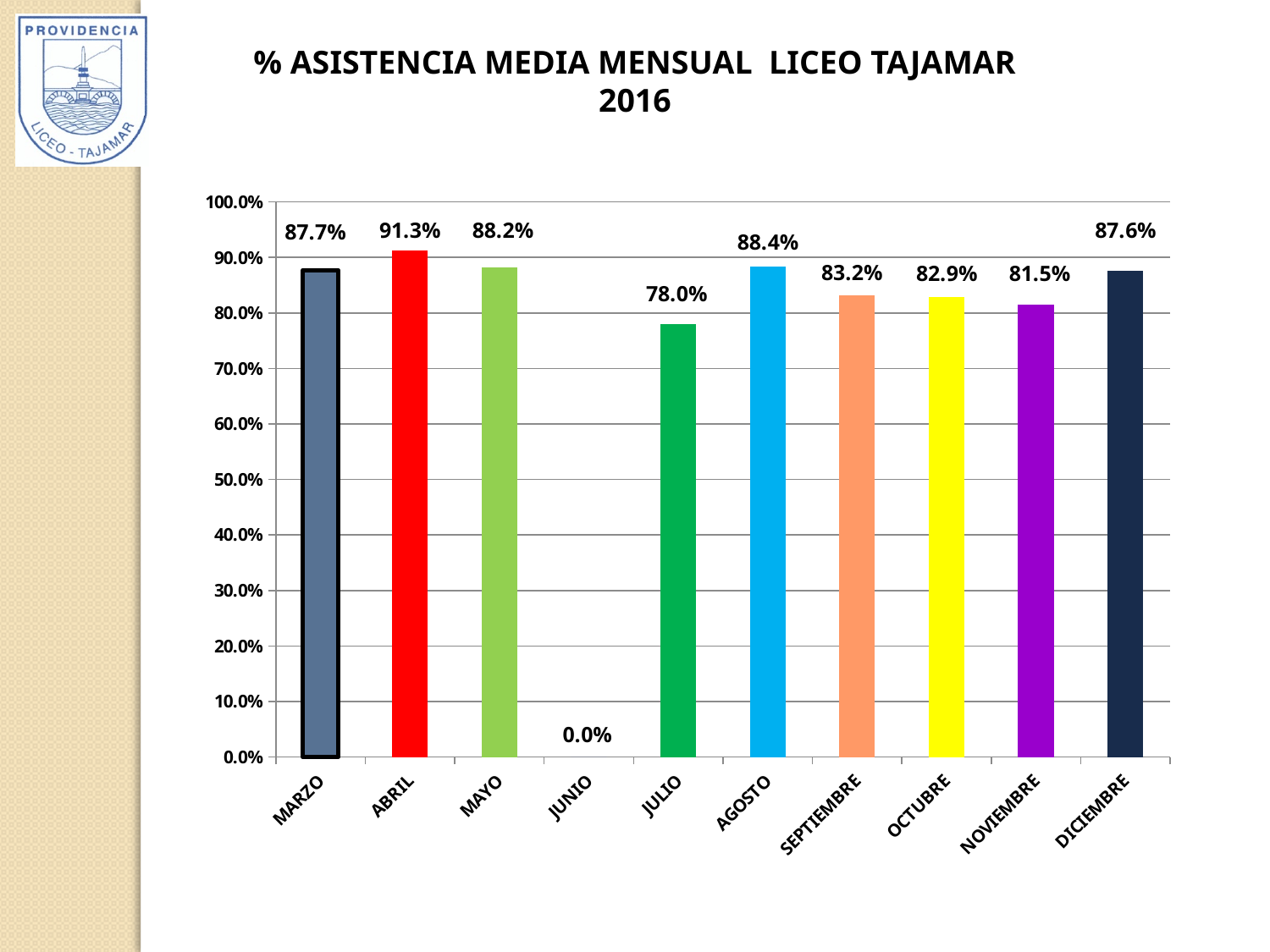
What is the title of the chart? % ASISTENCIA MEDIA MENSUAL LICEO TAJAMAR 2016 What is the difference between the values for ABRIL and JULIO? 13.3% Which month has the lowest value? JUNIO What is the value for ABRIL? 91.3% Is the value for SEPTIEMBRE greater or less than 90.0%? less What is the value for NOVIEMBRE? 81.5% How many months are shown on the x axis? 10 What kind of chart is this? bar chart What is the value for JULIO? 78.0% Which month has the highest value? ABRIL Which is larger, the value for MARZO or the value for DICIEMBRE? MARZO Do the values rise or fall from SEPTIEMBRE to NOVIEMBRE? fall